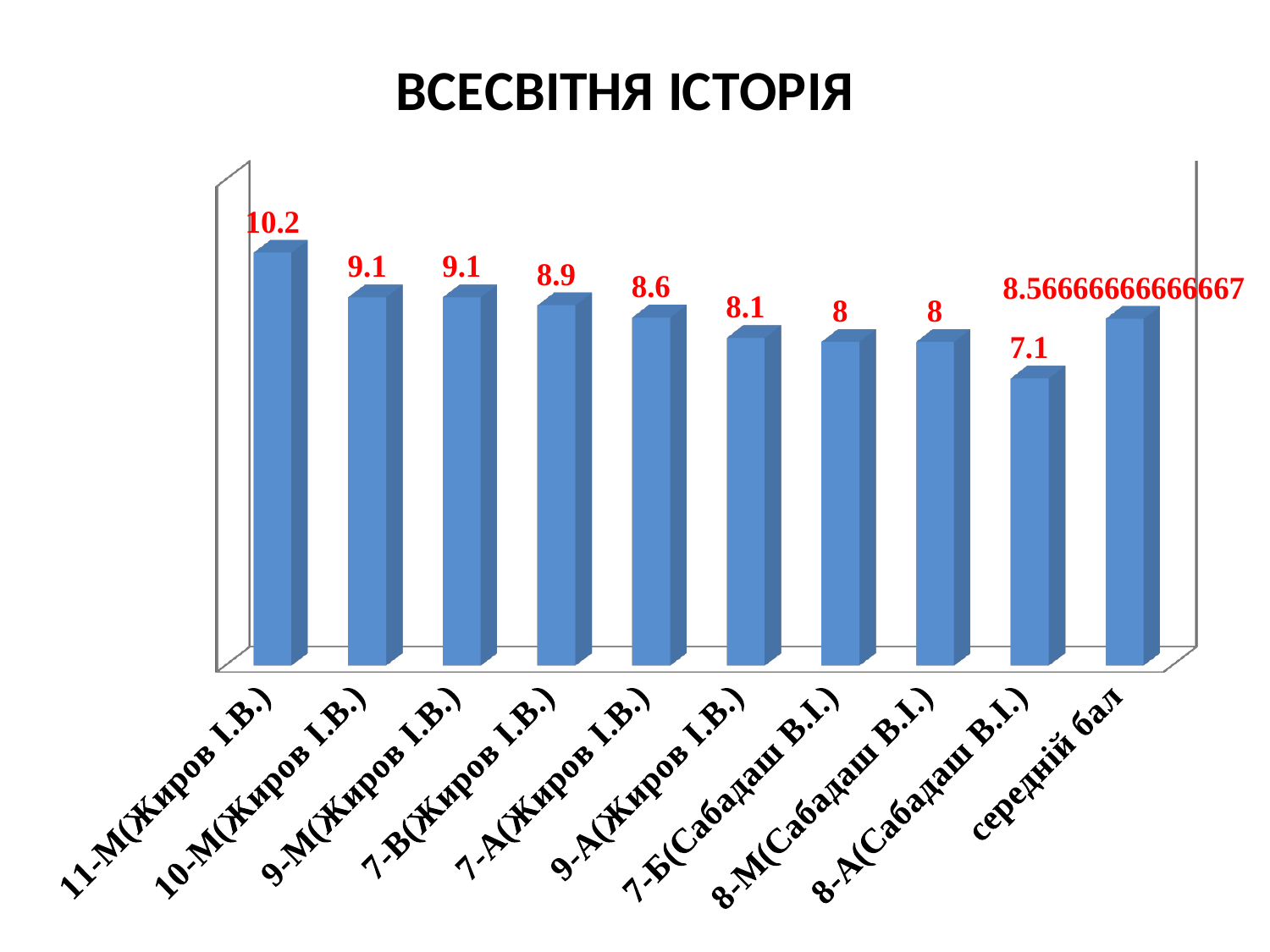
What kind of chart is shown on the slide? bar chart What is the difference between the values for 11-М(Жиров І.В.) and 8-А(Сабадаш В.І.)? 3.1 What is the value for 7-В(Жиров І.В.)? 8.9 What is the value for середній бал? 8.56666666666667 How many categories are shown on the chart? 10 What is the value for 11-М(Жиров І.В.)? 10.2 What is the value for 8-А(Сабадаш В.І.)? 7.1 Which category has the lowest value? 8-А(Сабадаш В.І.) What is the difference between the values for 7-А(Жиров І.В.) and 9-А(Жиров І.В.)? 0.5 Which category has the highest value? 11-М(Жиров І.В.) Which is larger, the value for 7-В(Жиров І.В.) or the value for 7-Б(Сабадаш В.І.)? 7-В(Жиров І.В.) What is the title of the chart? ВСЕСВІТНЯ ІСТОРІЯ